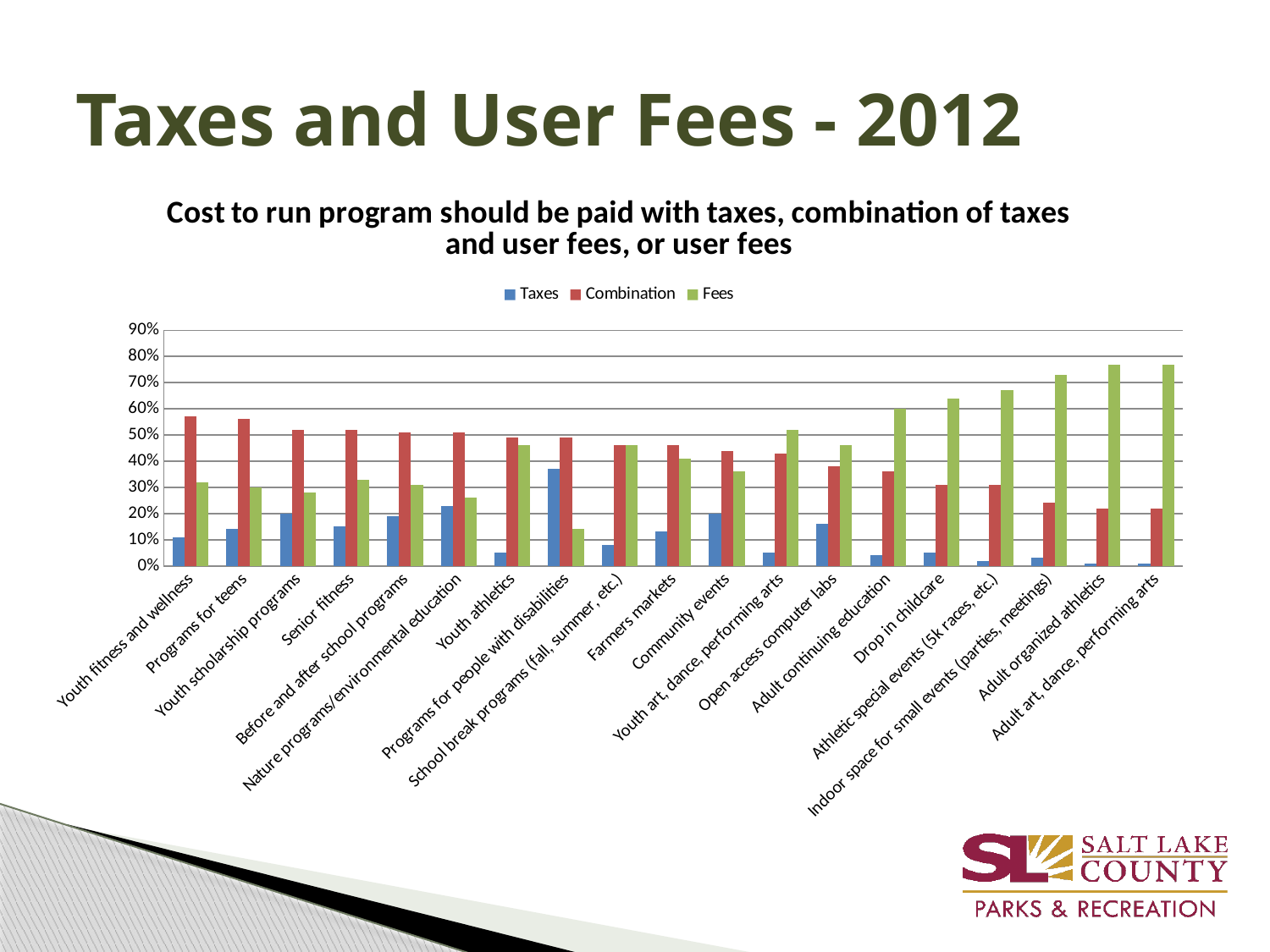
Which category has the highest Taxes value? Programs for people with disabilities Is the Taxes value for Programs for people with disabilities greater or less than 30%? greater Do the Fees values generally rise or fall moving from left to right along the x axis? rise How many program categories are shown on the x axis? 19 Is the Fees value for Drop in childcare greater or less than 60%? greater Is the Combination value for Youth fitness and wellness greater or less than 50%? greater What kind of chart is shown on the slide? bar chart How many series does the legend list? 3 For Adult organized athletics, which is larger: the Fees value or the Combination value? Fees What colour are the Fees bars? green Which category has the lowest Fees value? Programs for people with disabilities